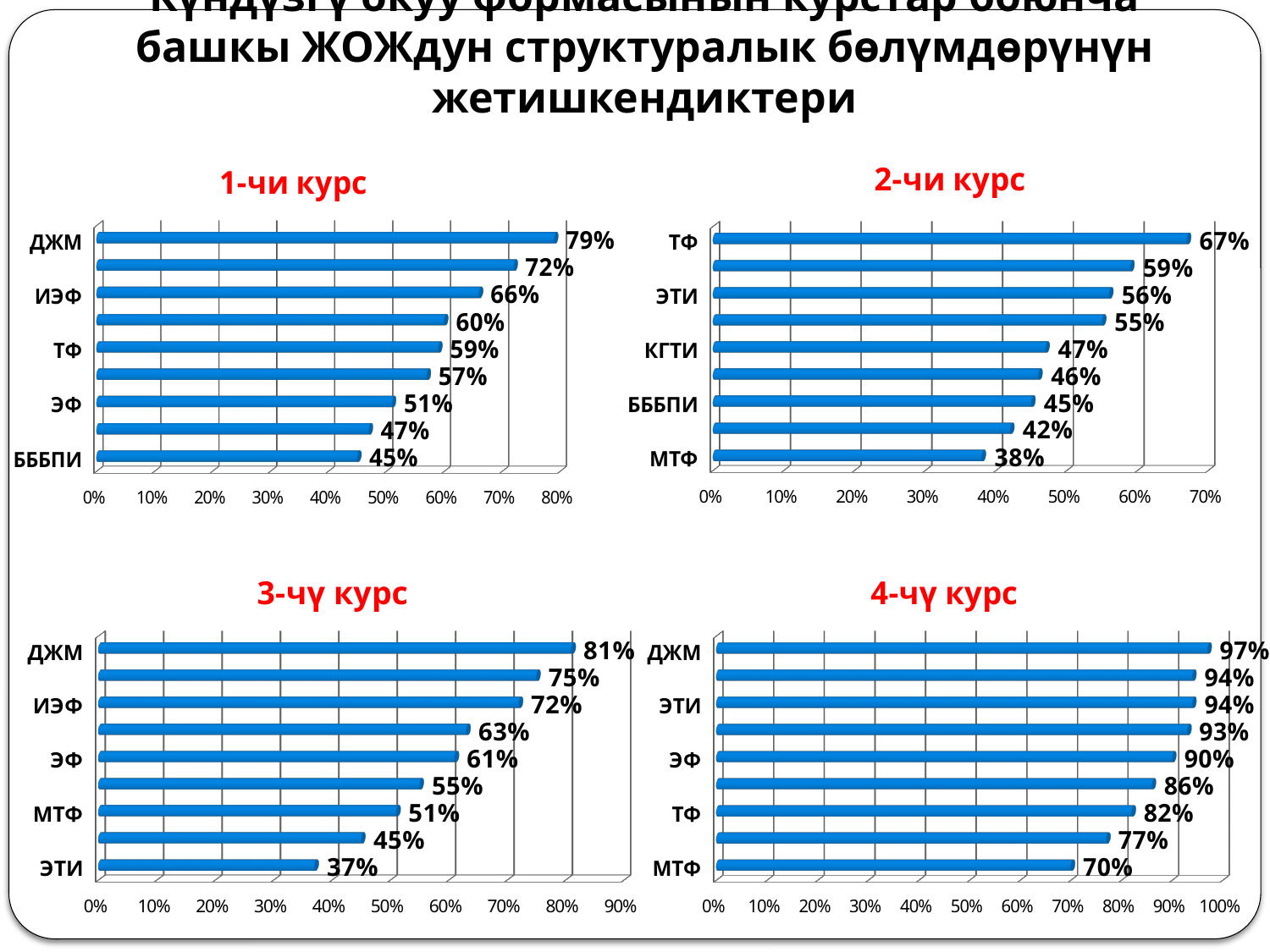
In the "1-чи курс" chart, which labeled category has the lowest value? БББПИ In the "3-чү курс" chart, what is the value for ЭТИ? 37% In the "4-чү курс" chart, which labeled category has the lowest value? МТФ What type of chart is the "4-чү курс" chart? Bar chart In the "1-чи курс" chart, what is the difference between the values for ДЖМ and БББПИ? 34% In the "3-чү курс" chart, what is the difference between the values for ИЭФ and МТФ? 21% How many bars are plotted in the "3-чү курс" chart? 9 In the "2-чи курс" chart, what is the value for КГТИ? 47% In the "4-чү курс" chart, what is the value for ТФ? 82% In the "1-чи курс" chart, what is the value for ДЖМ? 79% In the "2-чи курс" chart, which labeled category has the highest value? ТФ In the "2-чи курс" chart, which is larger, the value for ЭТИ or the value for МТФ? ЭТИ